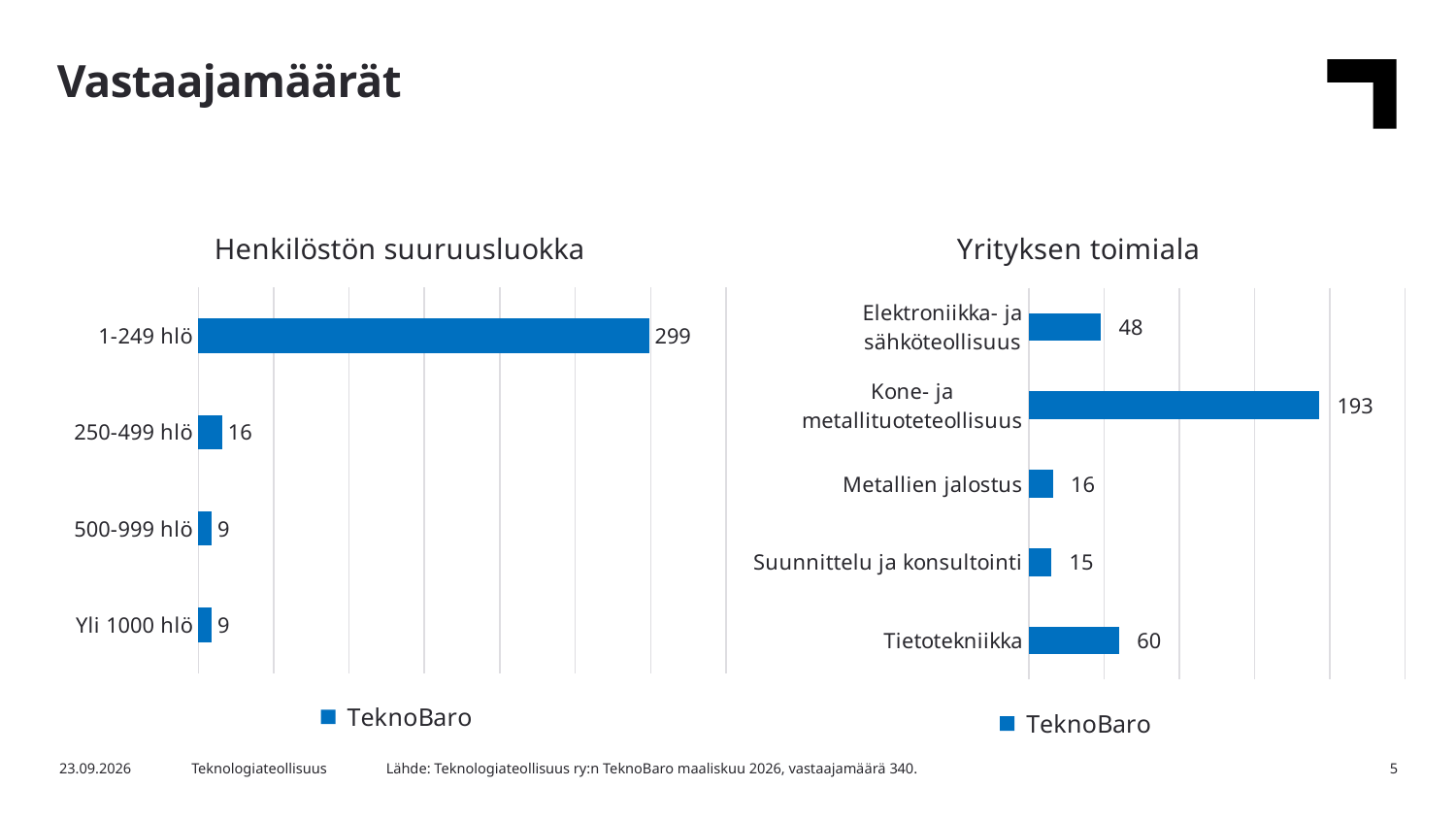
In the 'Yrityksen toimiala' chart, which category has the lowest value? Suunnittelu ja konsultointi In the 'Henkilöstön suuruusluokka' chart, what is the value for 250-499 hlö? 16 What type of chart is the 'Yrityksen toimiala' chart? Bar chart In the 'Henkilöstön suuruusluokka' chart, what is the difference between the values for 1-249 hlö and 250-499 hlö? 283 In the 'Yrityksen toimiala' chart, what is the value for Kone- ja metallituoteteollisuus? 193 In the 'Yrityksen toimiala' chart, what is the value for Tietotekniikka? 60 In the 'Yrityksen toimiala' chart, which is larger: Elektroniikka- ja sähköteollisuus or Tietotekniikka? Tietotekniikka How many categories are shown in the 'Henkilöstön suuruusluokka' chart? 4 In the 'Henkilöstön suuruusluokka' chart, which category has the highest value? 1-249 hlö How many categories are shown in the 'Yrityksen toimiala' chart? 5 In the 'Henkilöstön suuruusluokka' chart, what is the value for 1-249 hlö? 299 In the 'Yrityksen toimiala' chart, what is the difference between Kone- ja metallituoteteollisuus and Elektroniikka- ja sähköteollisuus? 145